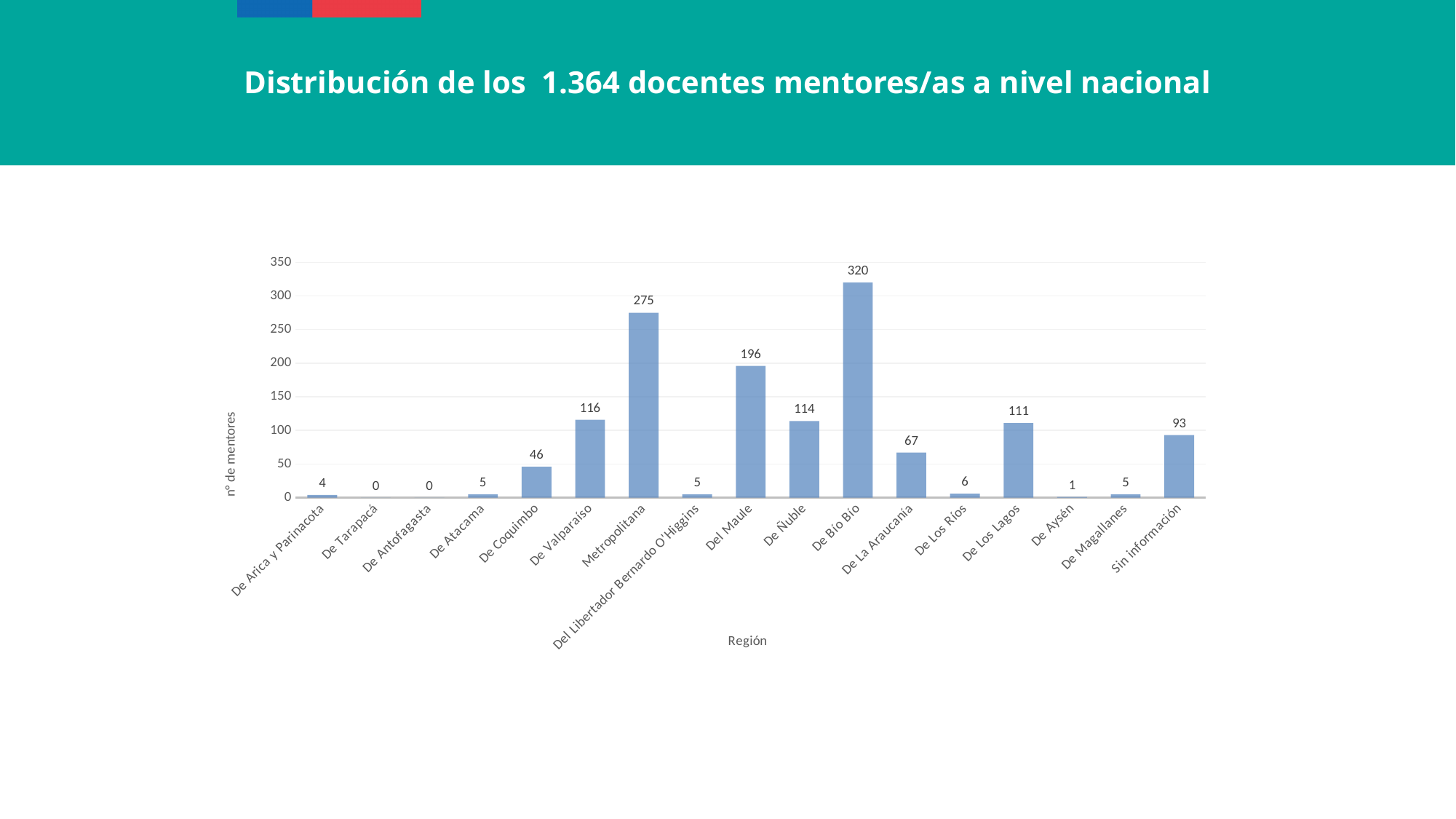
What is the value for De Los Lagos? 111 Is the value for De La Araucanía greater or less than 100? less How many categories have a value of 0? 2 Which is larger, the value for De Valparaíso or the value for De Ñuble? De Valparaíso What kind of chart is shown on the slide? bar chart What is the difference between the values for Del Maule and De Ñuble? 82 How many regions (categories) are shown on the x axis? 17 What is the label of the y axis? n° de mentores What is the difference between the values for De Bío Bío and Metropolitana? 45 What is the value for Metropolitana? 275 What is the value for Sin información? 93 Which region has the highest number of mentors? De Bío Bío